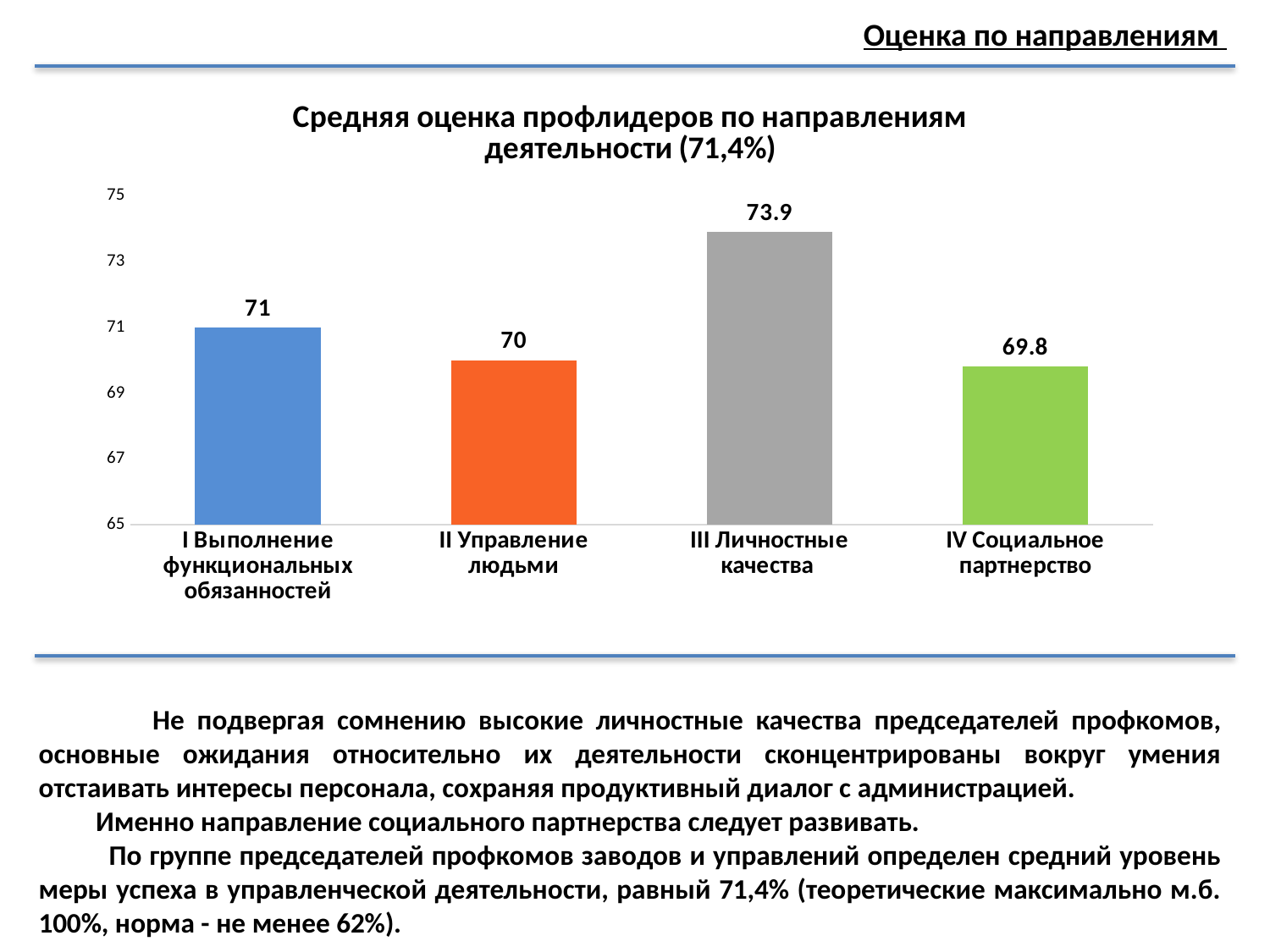
Which category has the lowest value? IV Социальное партнерство How many categories are shown in the chart? 4 What is the value for I Выполнение функциональных обязанностей? 71 What kind of chart is shown on the slide? bar chart Is the value for III Личностные качества greater or less than 73? greater What is the difference between the values for III Личностные качества and IV Социальное партнерство? 4.1 Which category has the highest value? III Личностные качества What is the title of the chart? Средняя оценка профлидеров по направлениям деятельности (71,4%) What is the value for IV Социальное партнерство? 69.8 Which is larger, the value for I Выполнение функциональных обязанностей or II Управление людьми? I Выполнение функциональных обязанностей What is the value for II Управление людьми? 70 What is the value for III Личностные качества? 73.9